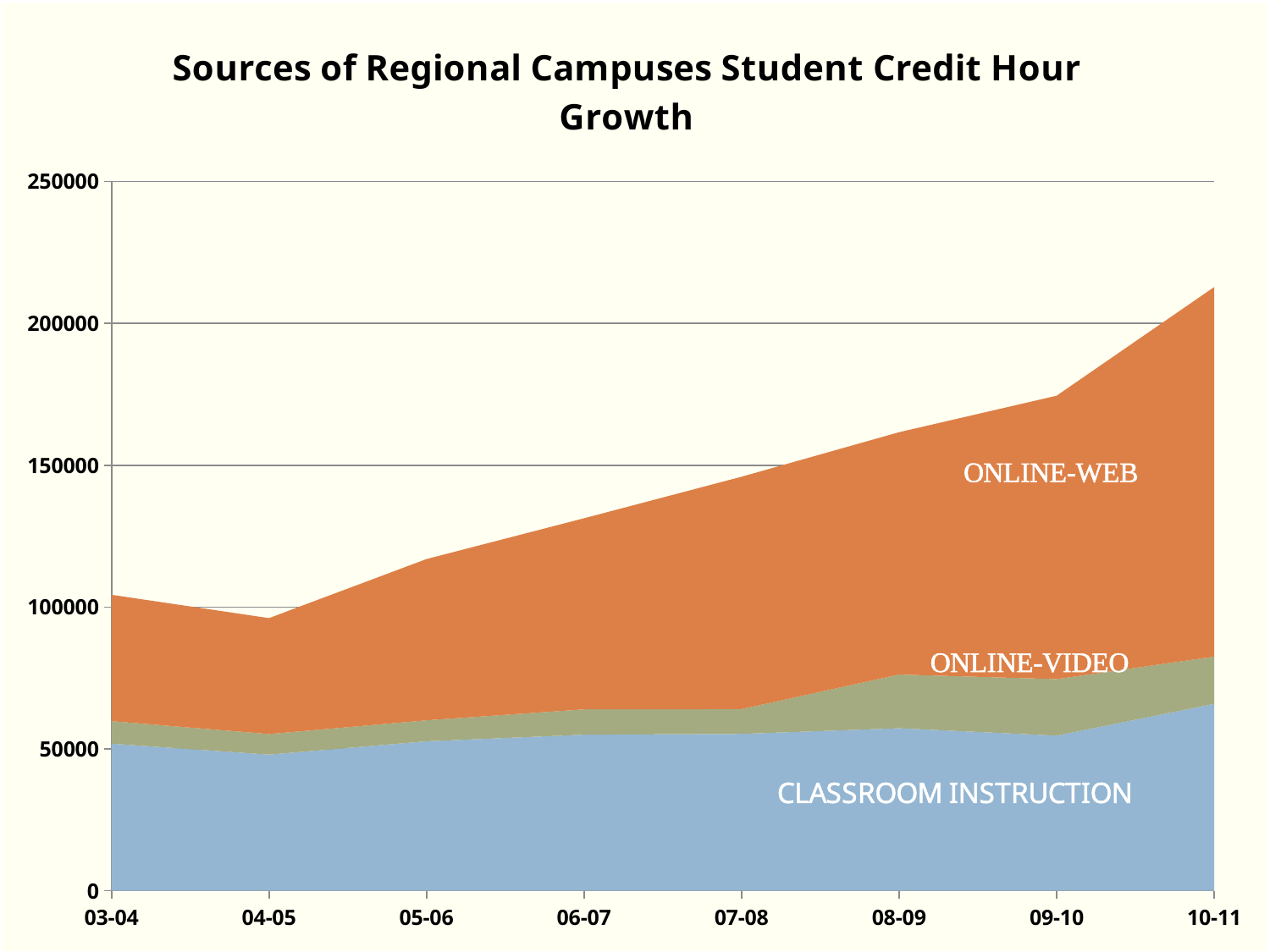
Which academic year has the highest total student credit hours? 10-11 Which series is plotted at the bottom of the stack? Classroom Instruction How many series (sources) are labeled in the chart? 3 Is the total for 09-10 greater or less than 200000? less Is the total for 10-11 greater or less than 200000? greater Which academic year has the lowest total student credit hours? 04-05 How many academic years are shown along the x axis? 8 What is the title of the chart? Sources of Regional Campuses Student Credit Hour Growth Does the total student credit hours generally rise or fall from 04-05 to 10-11? rise What kind of chart is shown on the slide? Stacked area chart Is the total for 08-09 greater or less than 150000? greater